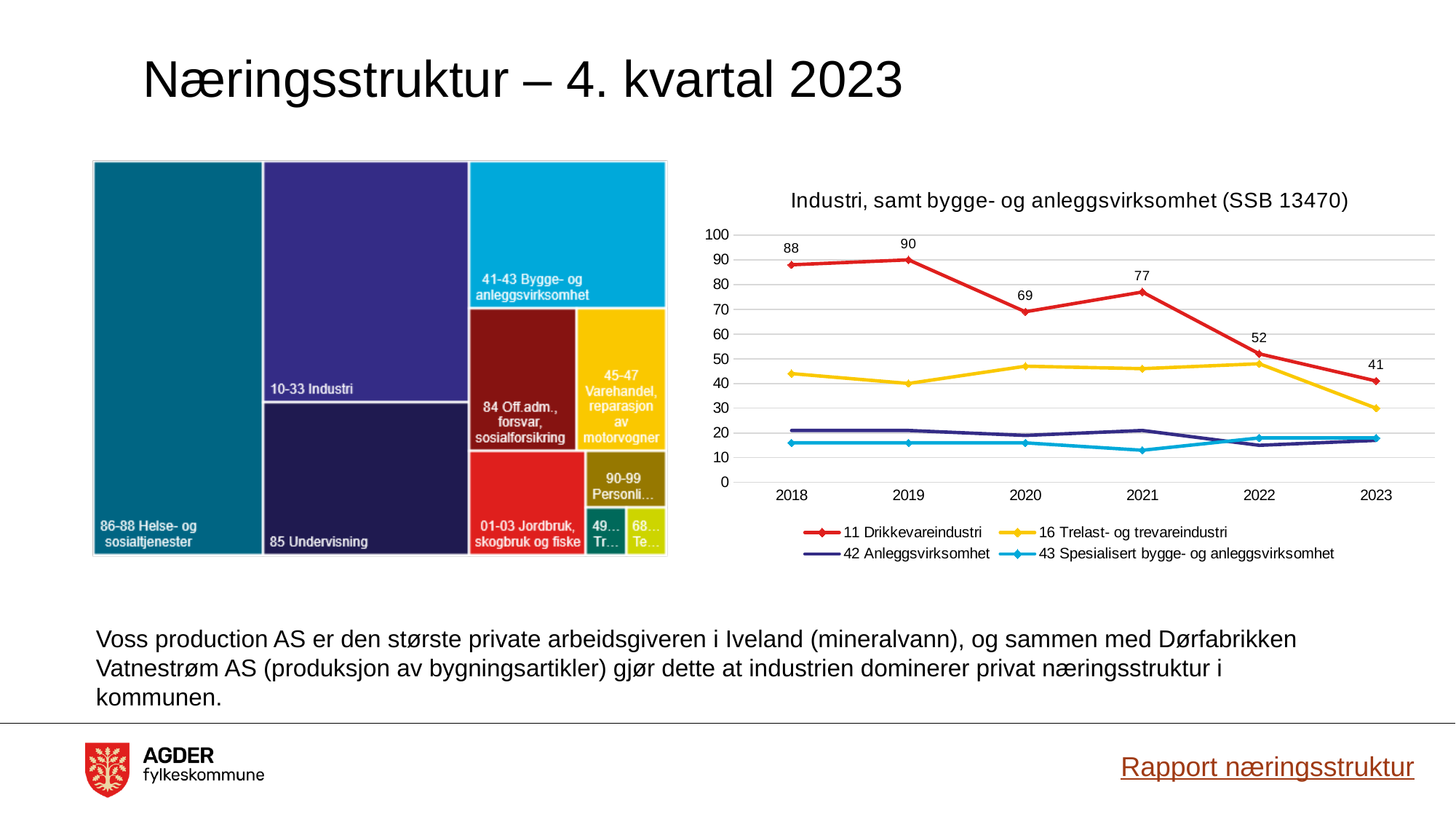
In the treemap on the left, which category occupies the largest area? 86-88 Helse- og sosialtjenester In the line chart on the right, how many years are shown on the x axis? 6 In the line chart on the right, how many series does the legend list? 4 In the line chart on the right, what is the value for 11 Drikkevareindustri in 2023? 41 What kind of chart is the chart on the right of the slide? line chart In the line chart on the right, does the value for 11 Drikkevareindustri rise or fall from 2018 to 2023? fall In the line chart on the right, what is the difference between the 2018 and 2023 values for 11 Drikkevareindustri? 47 In the line chart on the right, in which year is 11 Drikkevareindustri highest? 2019 In the line chart 'Industri, samt bygge- og anleggsvirksomhet (SSB 13470)', what is the value for 11 Drikkevareindustri in 2019? 90 In the line chart on the right, is the value for 11 Drikkevareindustri larger in 2020 or in 2021? 2021 In the line chart on the right, is the value for 16 Trelast- og trevareindustri in 2023 greater or less than 40? less In the line chart on the right, in which year is 11 Drikkevareindustri lowest? 2023